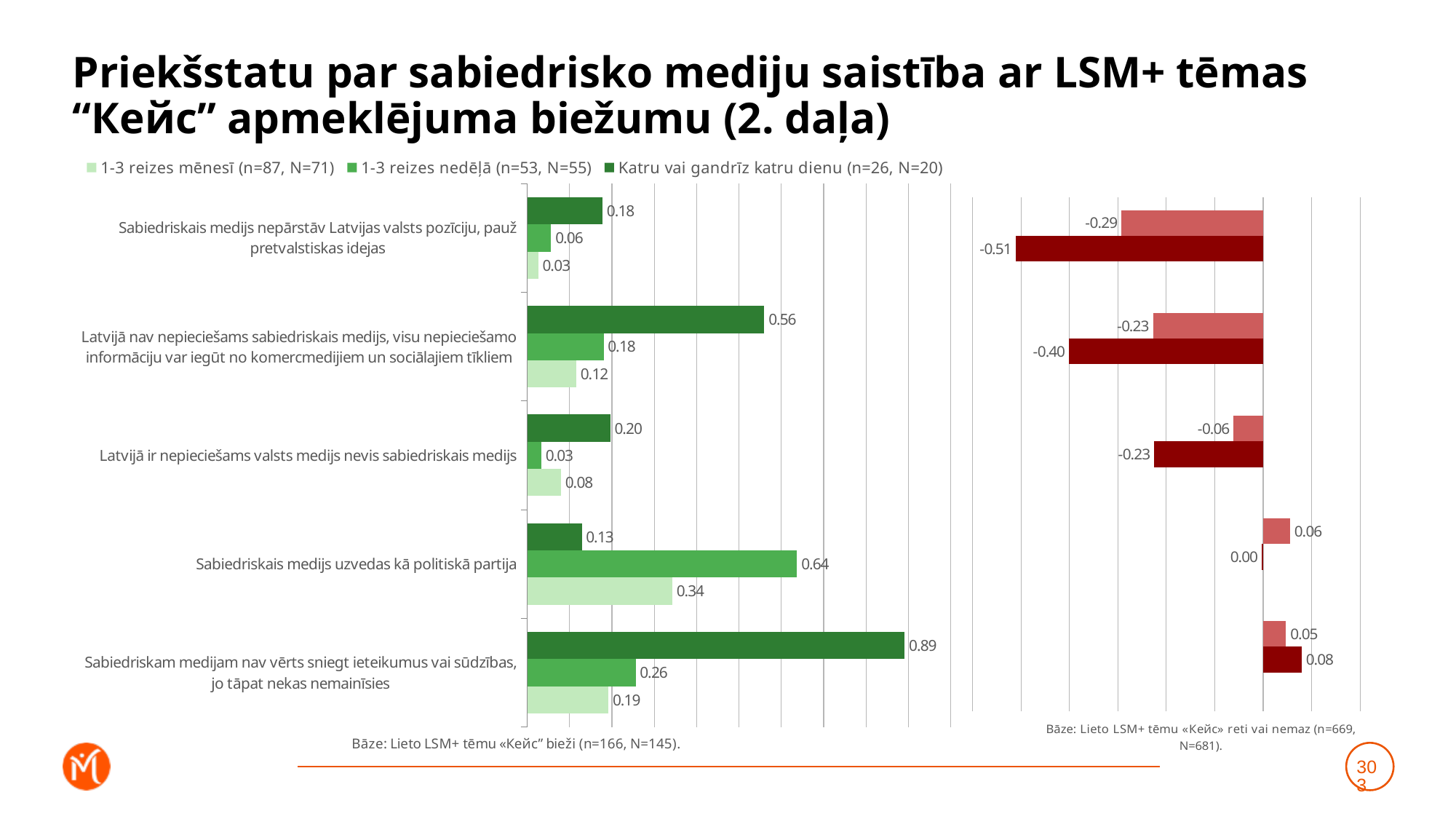
On the right (red) chart, what is the value of the dark red bar for "Sabiedriskais medijs nepārstāv Latvijas valsts pozīciju, pauž pretvalstiskas idejas"? -0.51 How many series does the legend of the left (green) chart list? 3 On the left (green) chart, for "Latvijā ir nepieciešams valsts medijs nevis sabiedriskais medijs", which is larger: the "1-3 reizes mēnesī" value or the "1-3 reizes nedēļā" value? 1-3 reizes mēnesī How many categories are shown on the left (green) chart? 5 On the left (green) chart, what is the value for "1-3 reizes mēnesī" for "Latvijā nav nepieciešams sabiedriskais medijs, visu nepieciešamo informāciju var iegūt no komercmedijiem un sociālajiem tīkliem"? 0.12 What kind of chart is the left (green) chart? Bar chart On the left (green) chart, what is the difference between the "1-3 reizes nedēļā" and "1-3 reizes mēnesī" values for "Sabiedriskais medijs uzvedas kā politiskā partija"? 0.30 On the left (green) chart, what is the value for "1-3 reizes nedēļā" for "Sabiedriskais medijs uzvedas kā politiskā partija"? 0.64 On the right (red) chart, what is the value of the lighter red bar for "Sabiedriskais medijs uzvedas kā politiskā partija"? 0.06 On the left (green) chart, which category has the lowest value for "1-3 reizes mēnesī"? Sabiedriskais medijs nepārstāv Latvijas valsts pozīciju, pauž pretvalstiskas idejas On the left (green) chart, which category has the highest value for "Katru vai gandrīz katru dienu"? Sabiedriskam medijam nav vērts sniegt ieteikumus vai sūdzības, jo tāpat nekas nemainīsies On the left (green) chart, what is the value for "Katru vai gandrīz katru dienu" for "Sabiedriskam medijam nav vērts sniegt ieteikumus vai sūdzības, jo tāpat nekas nemainīsies"? 0.89